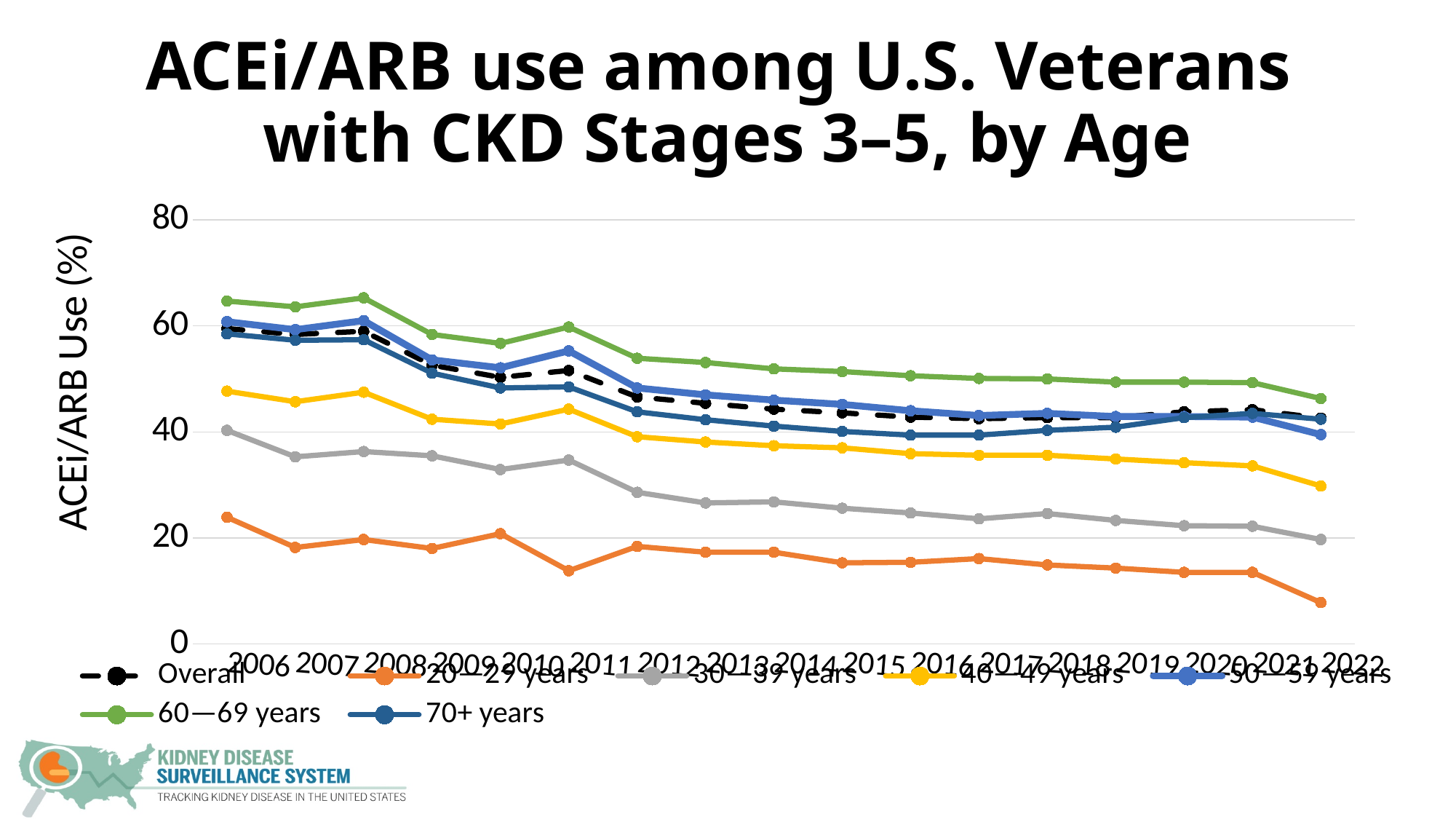
In 2006, which is larger: the value for 40—49 years or the value for 30—39 years? 40—49 years What type of chart is shown on the slide? line chart Is the value for 40—49 years in 2022 greater or less than 40? less How many years are shown along the x axis? 17 Which age group has the highest ACEi/ARB use in 2006? 60—69 years Is the value for 20—29 years in 2022 greater or less than 20? less Which age group has the lowest ACEi/ARB use in 2022? 20—29 years How many series does the legend list? 7 Is the value for 60—69 years in 2008 greater or less than 60? greater Which series is drawn with a dashed line? Overall Does ACEi/ARB use for the 60—69 years group rise or fall from 2006 to 2022? fall